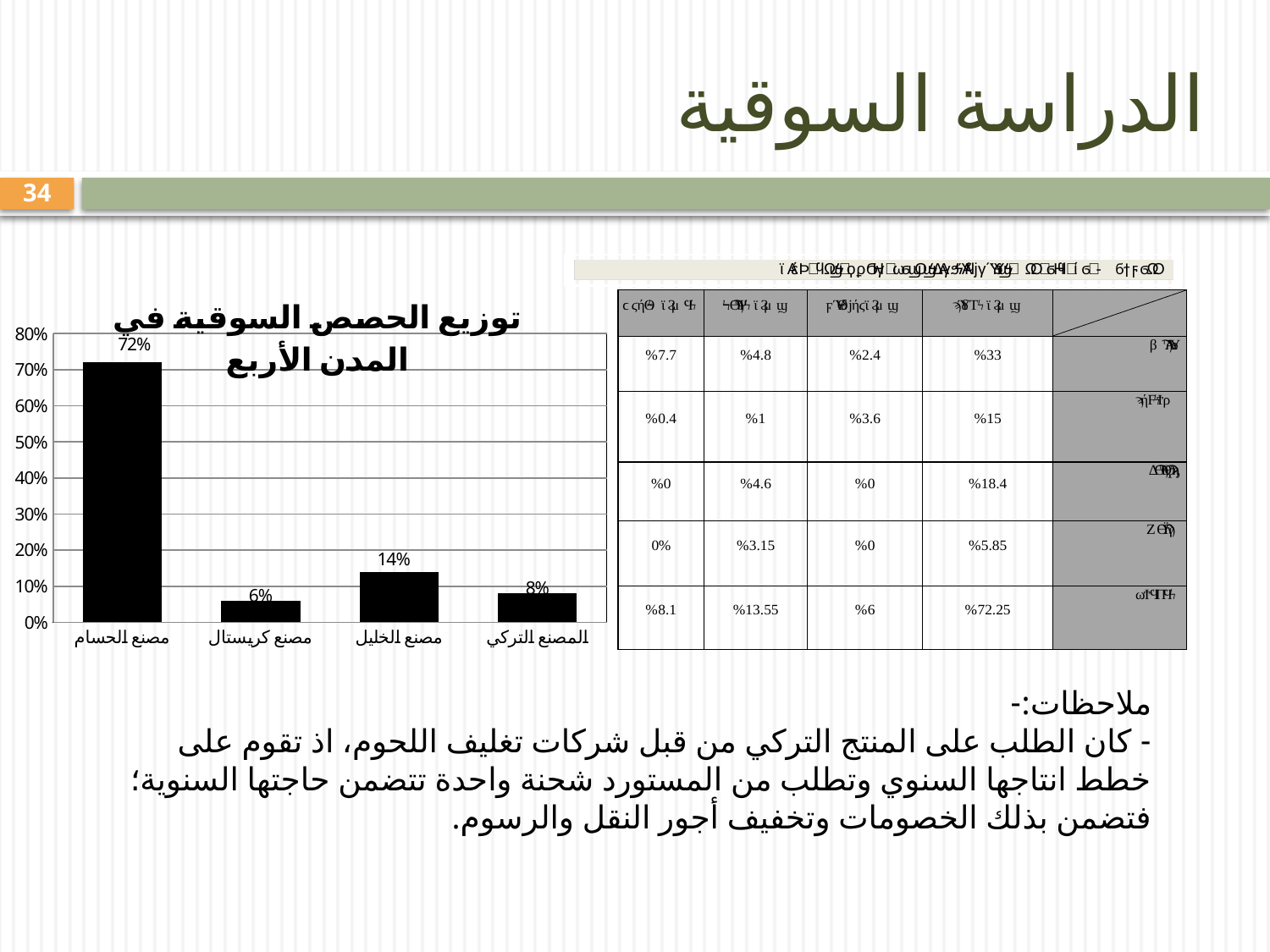
What is the title of the bar chart? توزيع الحصص السوقية في المدن الأربع What type of chart is used to show the market share distribution? bar chart What is the difference between the market shares of مصنع الحسام and مصنع الخليل? 58% Which factory has the highest market share in the bar chart? مصنع الحسام Is the value for مصنع الحسام greater or less than 70%? greater What is the market share shown for المصنع التركي in the bar chart? 8% Which factory has the lowest market share in the bar chart? مصنع كريستال How many factories are shown in the bar chart? 4 What is the market share shown for مصنع الحسام in the bar chart? 72% What is the market share shown for مصنع الخليل in the bar chart? 14% What is the market share shown for مصنع كريستال in the bar chart? 6% Which has a larger market share, مصنع الخليل or المصنع التركي? مصنع الخليل